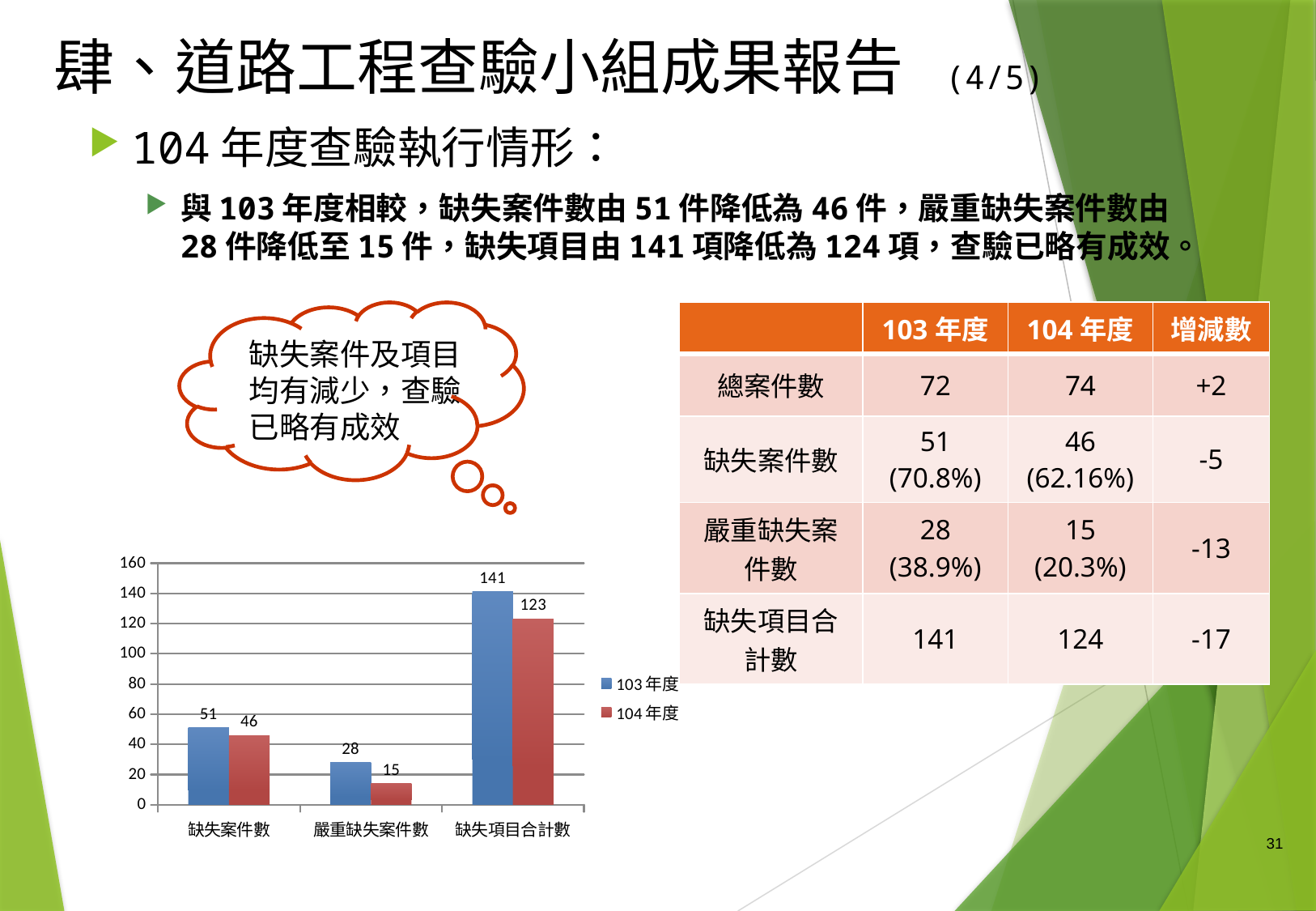
What is the value for 缺失案件數 in the 103 年度 series? 51 Which category has the lowest value in the 104 年度 series? 嚴重缺失案件數 Which category has the highest value in the 103 年度 series? 缺失項目合計數 How many series does the chart legend list? 2 What is the value for 缺失案件數 in the 104 年度 series? 46 What kind of chart is shown on the slide? bar chart Which colour represents the 104 年度 series in the chart? red What is the value for 缺失項目合計數 in the 104 年度 series according to the chart's data label? 123 How many categories are shown on the x axis of the chart? 3 Which is larger for 缺失案件數: the 103 年度 value or the 104 年度 value? 103 年度 What is the difference between the 103 年度 and 104 年度 values for 嚴重缺失案件數? 13 What is the value for 嚴重缺失案件數 in the 104 年度 series? 15